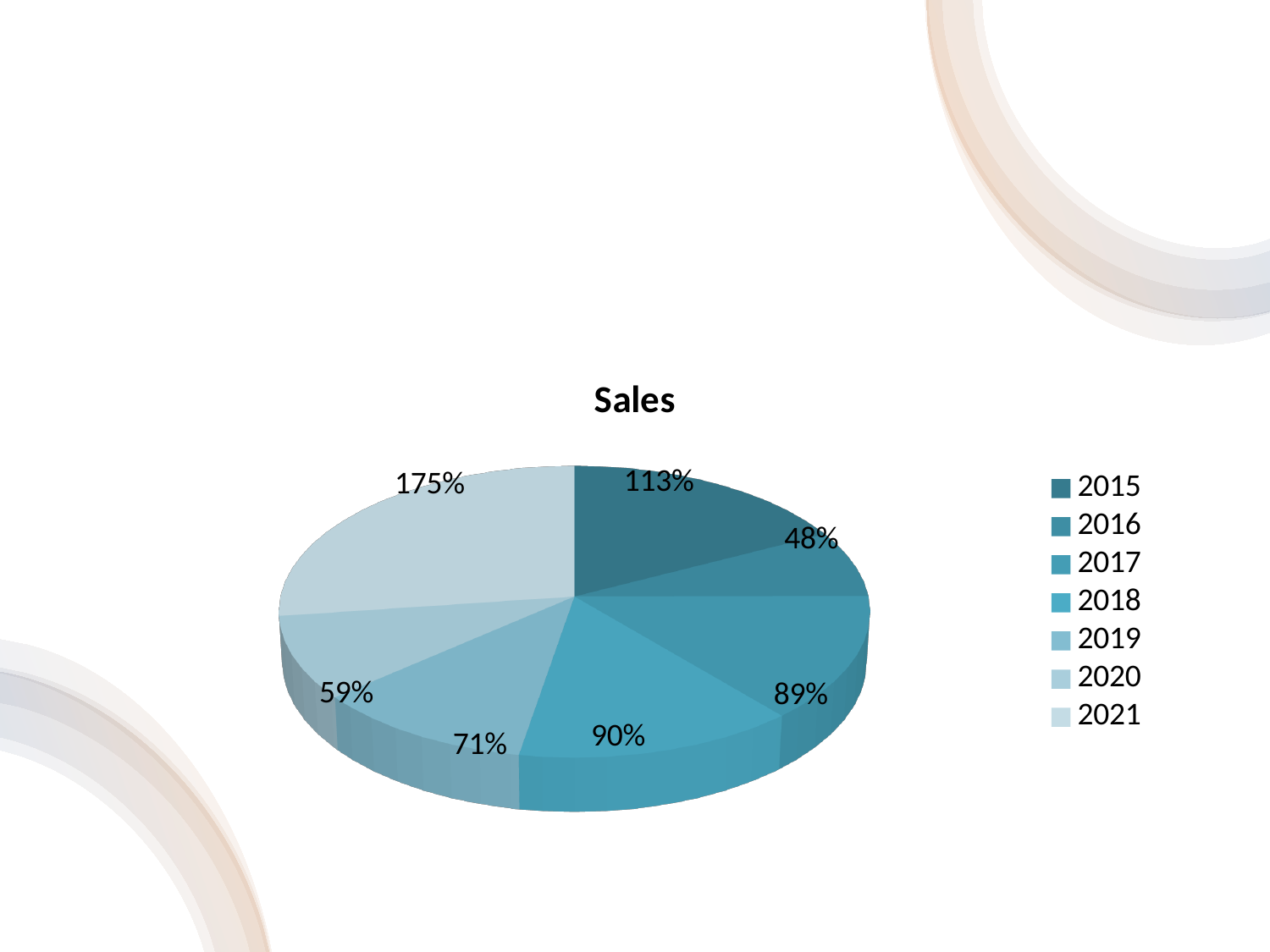
How many slices does the Sales pie chart have? 7 What is the value shown for 2021 in the Sales pie chart? 175% Which is larger in the Sales pie chart, the value for 2015 or the value for 2019? 2015 Which year has the smallest slice in the Sales pie chart? 2016 Which year has the largest slice in the Sales pie chart? 2021 What kind of chart is shown on the slide? Pie chart What is the title of the chart on the slide? Sales What is the value shown for 2018 in the Sales pie chart? 90% What is the value shown for 2020 in the Sales pie chart? 59% What is the value shown for 2016 in the Sales pie chart? 48% What is the difference between the values for 2021 and 2016 in the Sales pie chart? 127% What is the value shown for 2015 in the Sales pie chart? 113%